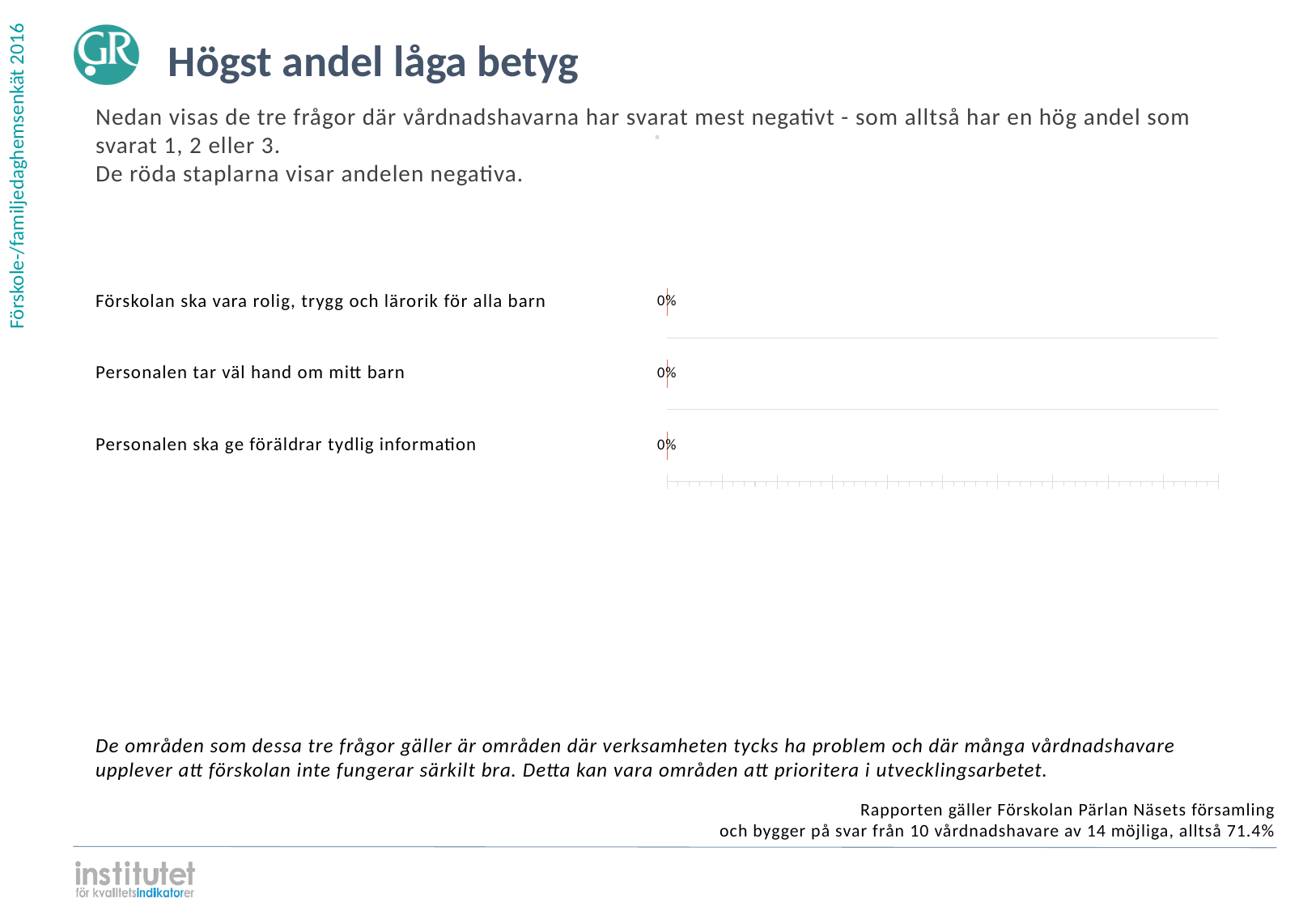
What is the value for "Personalen ska ge föräldrar tydlig information"? 0% How many categories are shown in the chart? 3 What is the value for "Personalen tar väl hand om mitt barn"? 0% What is the title of the slide containing the chart? Högst andel låga betyg What is the value for "Förskolan ska vara rolig, trygg och lärorik för alla barn"? 0% What is the difference between the values for "Personalen tar väl hand om mitt barn" and "Personalen ska ge föräldrar tydlig information"? 0% Do all three categories in the chart have the same value? Yes What kind of chart is shown on the slide? Bar chart According to the slide text, what do the red bars show? Andelen negativa